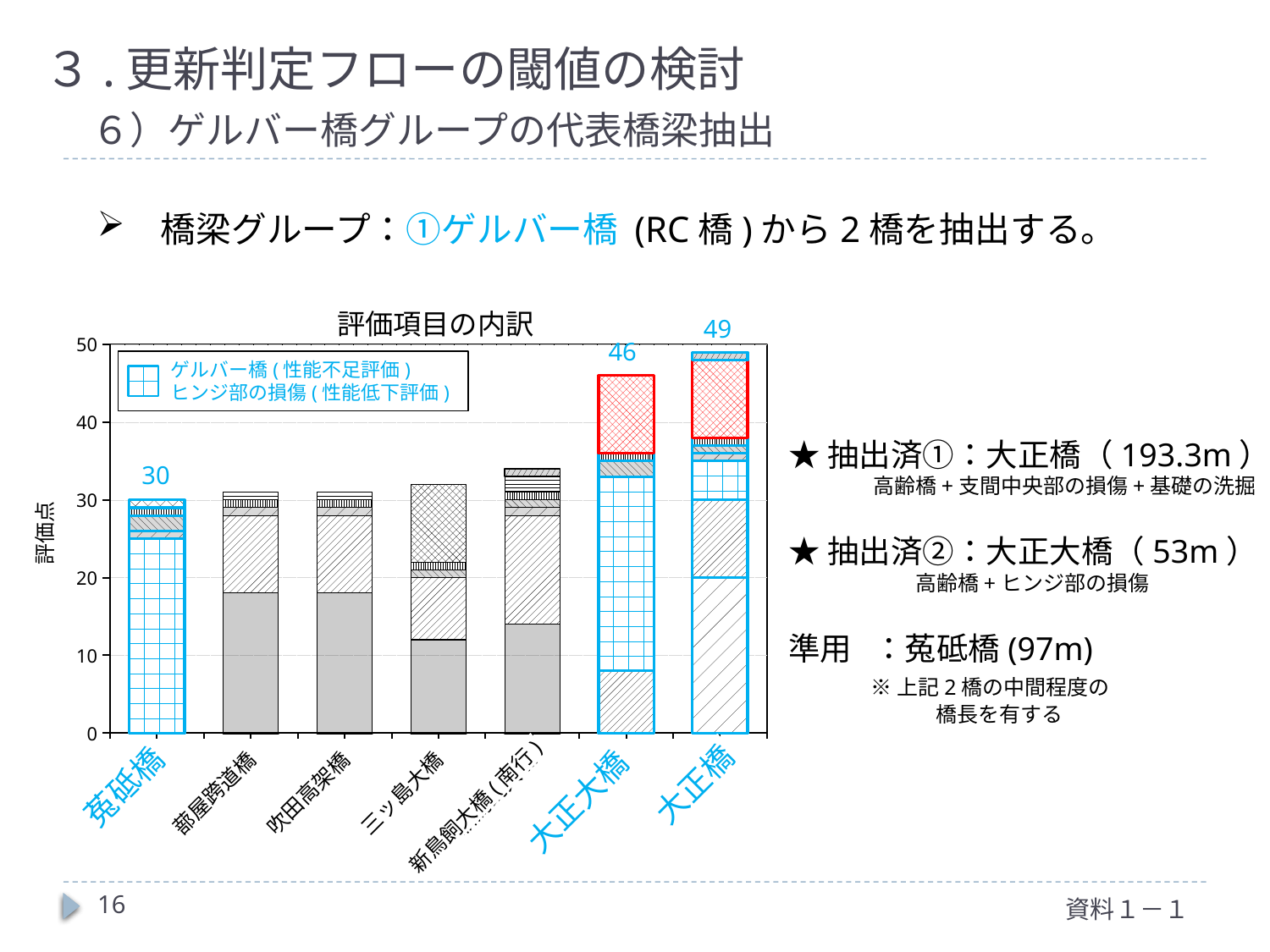
What kind of chart is shown on the slide? Stacked bar chart Is the total value for 新鳥飼大橋(南行) greater or less than 30? greater What is the total evaluation score shown for 大正橋? 49 What is the total evaluation score shown for 大正大橋? 46 Is the total value for 三ッ島大橋 greater or less than 40? less What is the title of the chart? 評価項目の内訳 Which has a larger total score, 大正大橋 or 菟砥橋? 大正大橋 What is the total evaluation score shown for 菟砥橋? 30 What is the difference between the total scores of 大正橋 and 大正大橋? 3 What is the difference between the total scores of 大正橋 and 菟砥橋? 19 Which bridge has the highest total evaluation score? 大正橋 How many bridges are shown on the x axis of the chart? 7